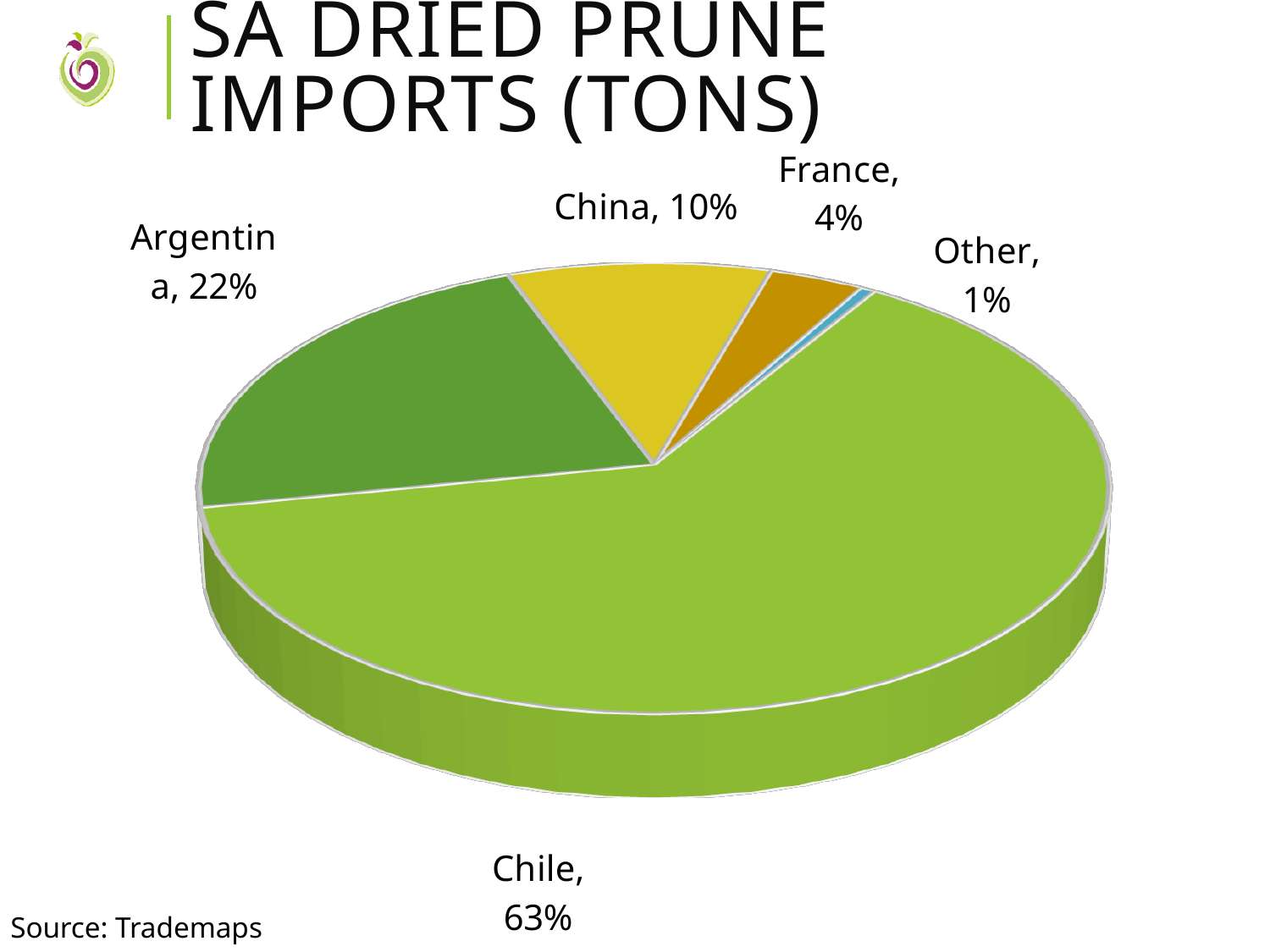
Which has a larger share of SA dried prune imports, China or France? China What share of SA dried prune imports comes from China? 10% How many slices does the pie chart have? 5 Which slice has the smallest share of SA dried prune imports? Other What share of SA dried prune imports comes from France? 4% Which country has the largest share of SA dried prune imports? Chile What share of SA dried prune imports is labelled Other? 1% What is the source cited for the chart? Trademaps What is the difference in percentage points between Chile's share and Argentina's share? 41 What kind of chart is shown on the slide? Pie chart